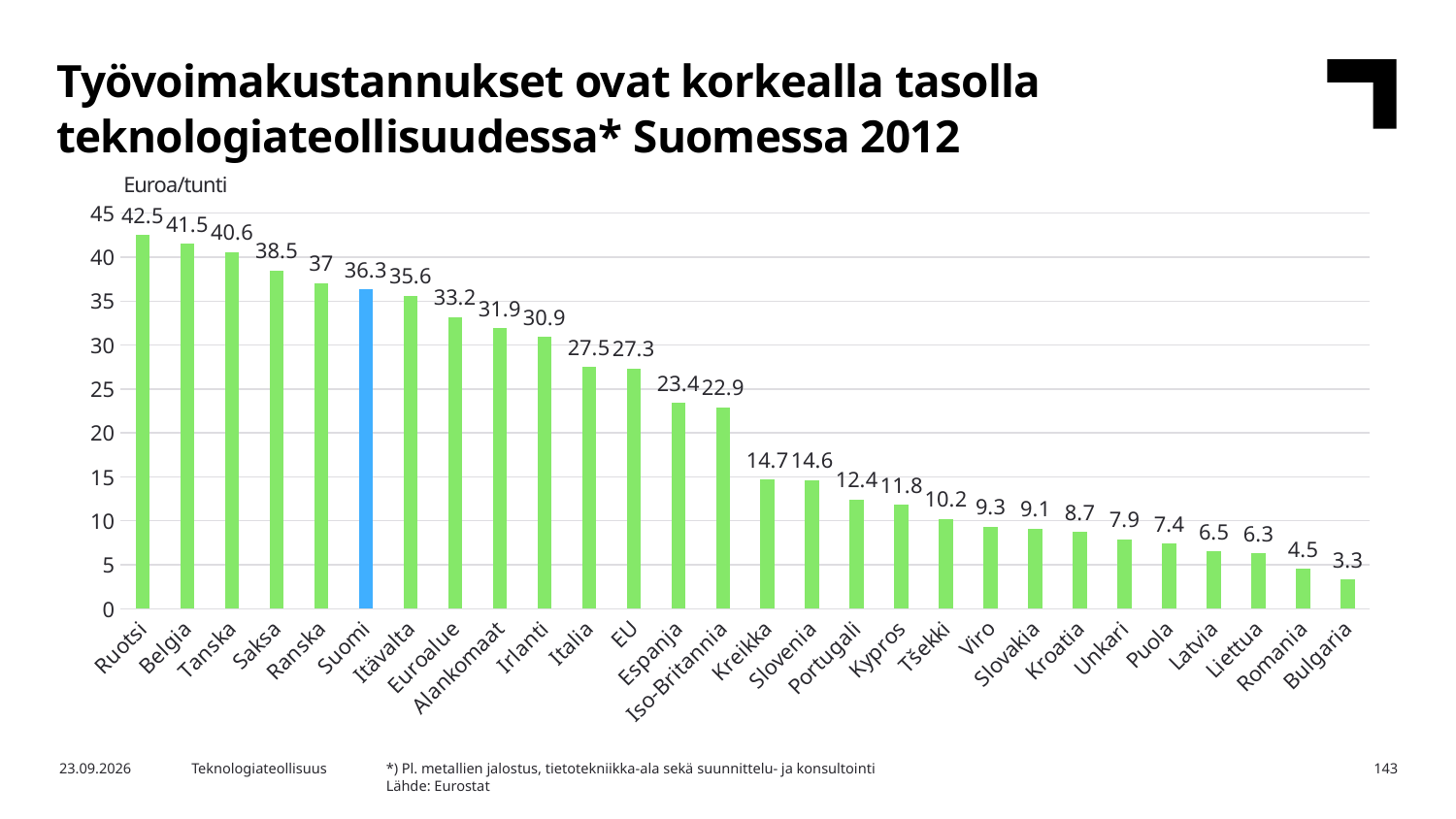
What is the difference between the values for Ruotsi and Suomi? 6.2 What is the value for Saksa? 38.5 How many countries or regions are shown in the chart? 28 Is the value for Kreikka greater or less than 15? less Do the values rise or fall from left to right along the x axis? fall Which is larger, the value for Euroalue or the value for EU? Euroalue Which country has the lowest value? Bulgaria Which country has the highest value? Ruotsi What is the value for Iso-Britannia? 22.9 What kind of chart is shown on the slide? bar chart Which bar is coloured differently (blue) from the others? Suomi What is the value for Suomi? 36.3